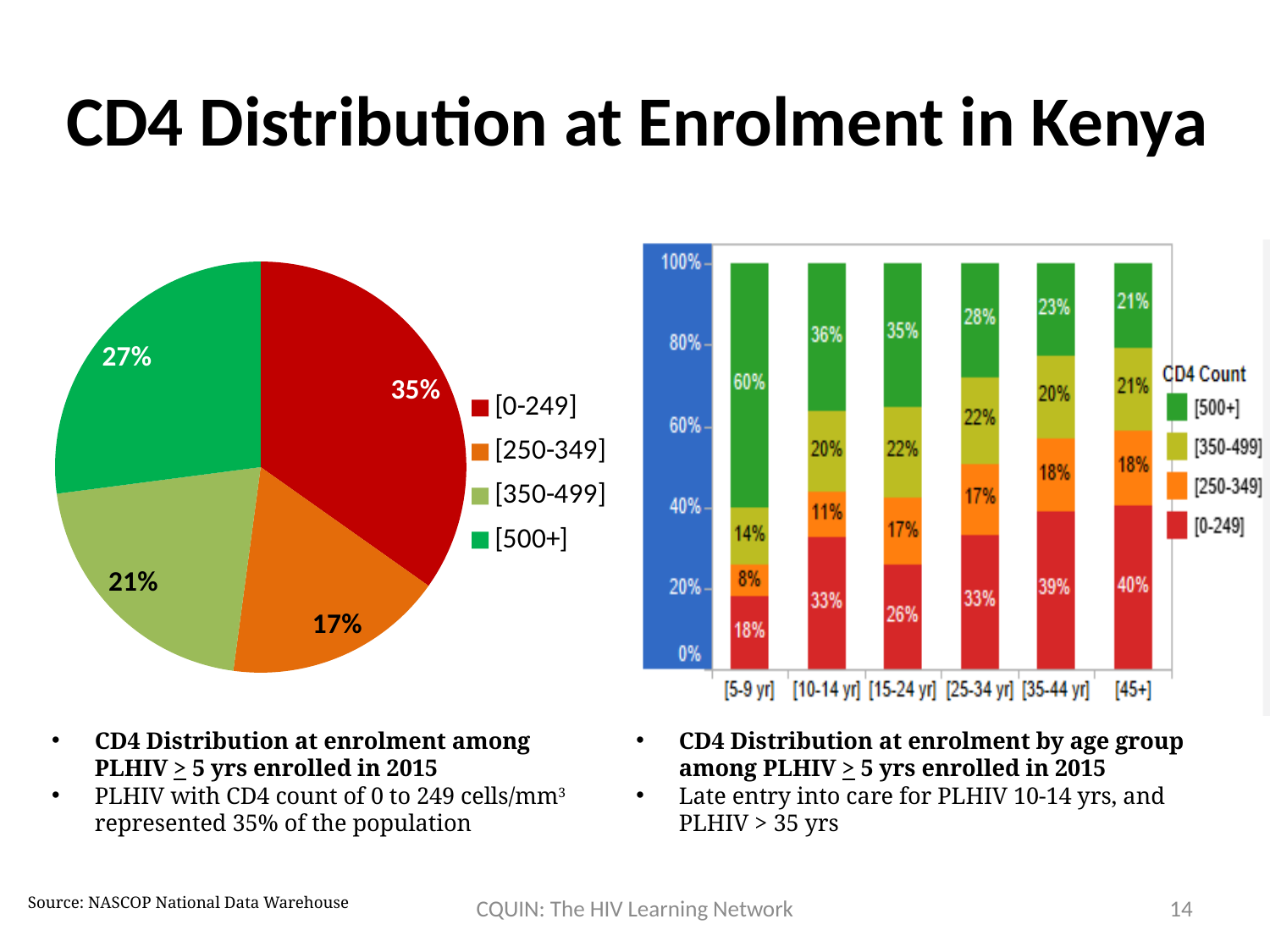
In the stacked bar chart on the right, what percentage of the [45+] age group had a CD4 count of [0-249]? 40% In the stacked bar chart on the right, what percentage of the [5-9 yr] age group had a CD4 count of [500+]? 60% In the pie chart on the left, what share of PLHIV had a CD4 count of [0-249]? 35% How many categories does the legend of the pie chart on the left list? 4 In the stacked bar chart on the right, does the [500+] percentage rise or fall across the age groups from [5-9 yr] to [45+]? Fall In the stacked bar chart on the right, is the [500+] percentage for [10-14 yr] larger or smaller than for [35-44 yr]? Larger In the stacked bar chart on the right, which age group has the highest [0-249] percentage? [45+] In the stacked bar chart on the right, how many age groups are shown on the x axis? 6 What kind of chart is the chart on the right of the slide? Stacked bar chart In the pie chart on the left, which CD4 category has the largest share? [0-249] In the pie chart on the left, which CD4 category has the smallest share? [250-349] In the pie chart on the left, what is the difference between the [500+] share and the [350-499] share? 6%